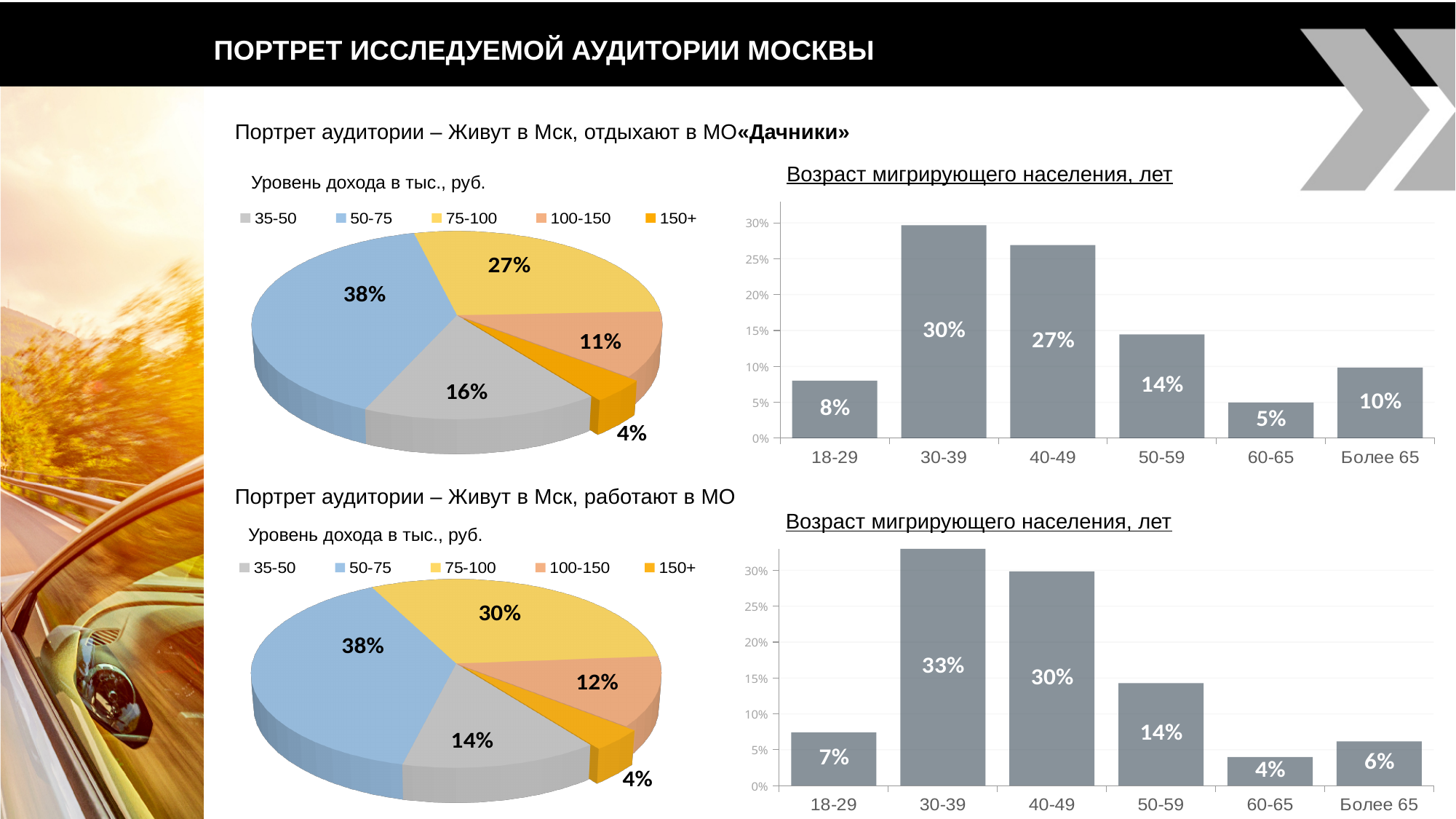
In the top-right bar chart (age of migrating population, «Дачники»), what is the value for the 30-39 group? 30% In the bottom-right bar chart (age of migrating population, live in Moscow, work in MO), which age group has the highest value? 30-39 In the top-right bar chart (age of migrating population, «Дачники»), how many age groups are shown? 6 In the top-right bar chart (age of migrating population, «Дачники»), what is the difference between the 30-39 and 18-29 groups? 22% In the bottom-right bar chart (age of migrating population, live in Moscow, work in MO), what is the value for the Более 65 group? 6% In the bottom-left pie chart (income level, live in Moscow, work in MO), what share does the 75-100 category have? 30% In the top-right bar chart (age of migrating population, «Дачники»), which age group has the lowest value? 60-65 In the bottom-right bar chart (age of migrating population, live in Moscow, work in MO), what is the difference between the 40-49 and 50-59 groups? 16% How many categories does the legend of the top-left pie chart list? 5 In the top-left pie chart (income level, «Дачники»), which income category has the smallest share? 150+ In the top-left pie chart (income level, «Дачники»), what share does the 50-75 category have? 38% In the bottom-left pie chart (income level, live in Moscow, work in MO), which is larger: the 35-50 share or the 100-150 share? 35-50